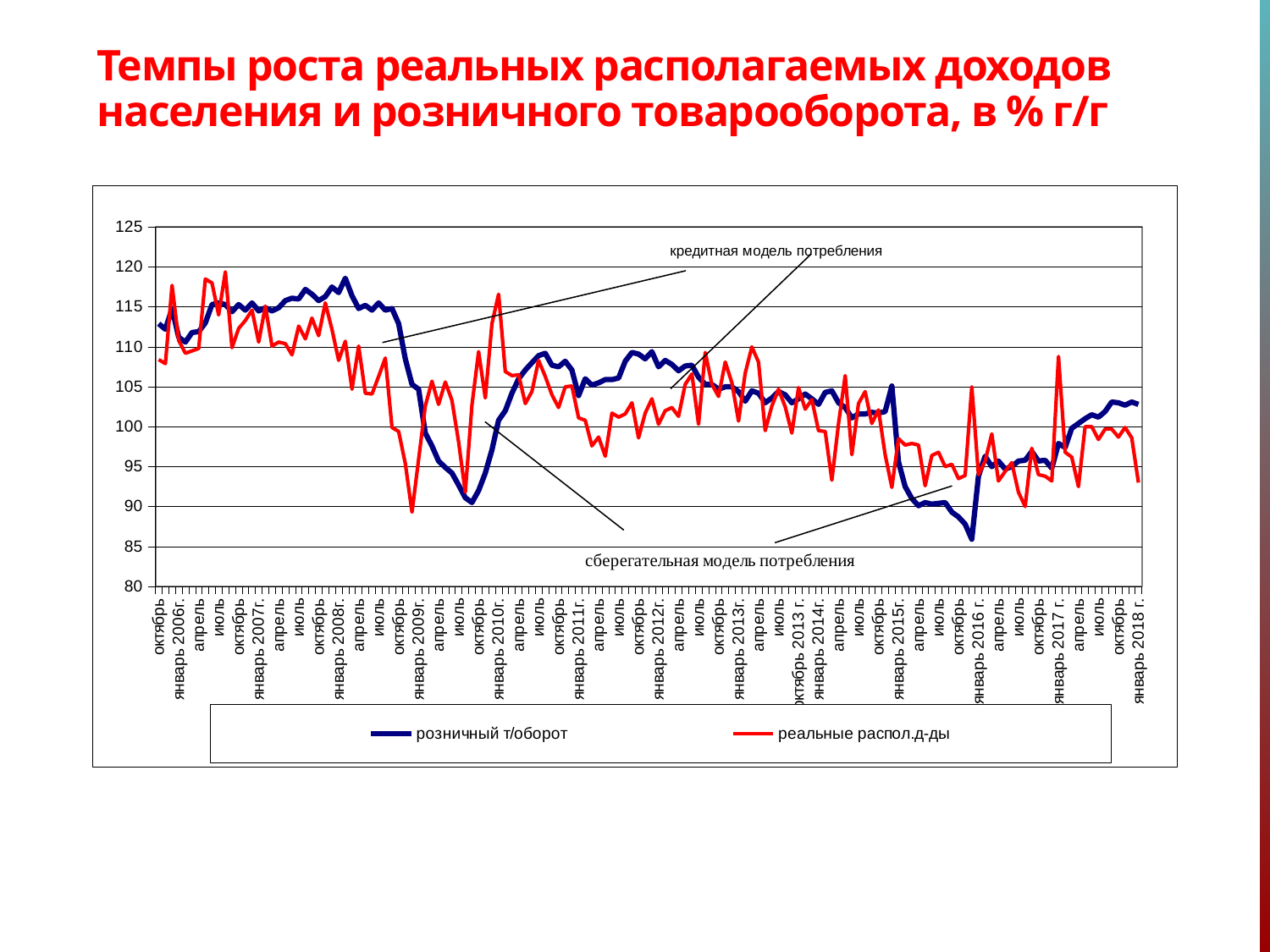
At январь 2008 г., which series has the higher value, розничный т/оборот or реальные распол.д-ды? розничный т/оборот Does the розничный т/оборот line rise or fall between январь 2008 г. and октябрь 2009 г.? fall Is the value of розничный т/оборот at октябрь 2009 г. greater or less than 95? less What kind of chart is shown on the slide? line chart How many series does the legend list? 2 Which series is drawn in red? реальные распол.д-ды Is the value of реальные распол.д-ды at январь 2017 г. greater or less than 105? greater Is the value of розничный т/оборот at январь 2008 г. greater or less than 115? greater What are the two consumption models labelled on the chart? кредитная модель потребления and сберегательная модель потребления